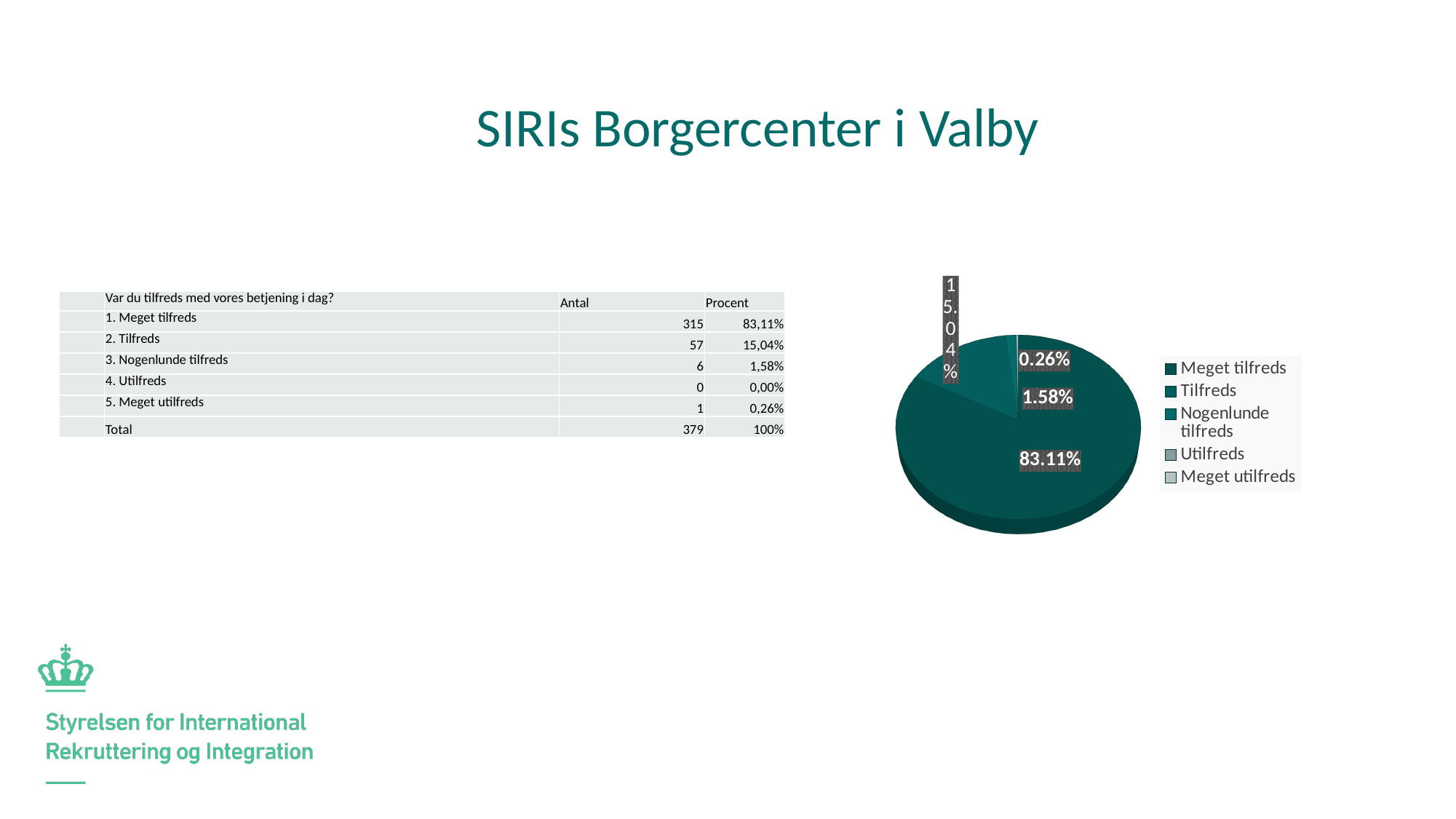
What share of the pie chart does the Tilfreds slice represent? 15.04% Which legend entry in the pie chart is listed first? Meget tilfreds What share of the pie chart does the Meget tilfreds slice represent? 83.11% What kind of chart is shown on the slide? pie chart Which slice is larger in the pie chart, Nogenlunde tilfreds or Meget utilfreds? Nogenlunde tilfreds How many entries does the legend of the pie chart list? 5 What share of the pie chart does the Nogenlunde tilfreds slice represent? 1.58% Which category has the largest slice in the pie chart? Meget tilfreds What is the difference in percentage points between the Meget tilfreds slice and the Tilfreds slice in the pie chart? 68.07 Which slice is larger in the pie chart, Tilfreds or Nogenlunde tilfreds? Tilfreds Which legend entry in the pie chart is listed last? Meget utilfreds